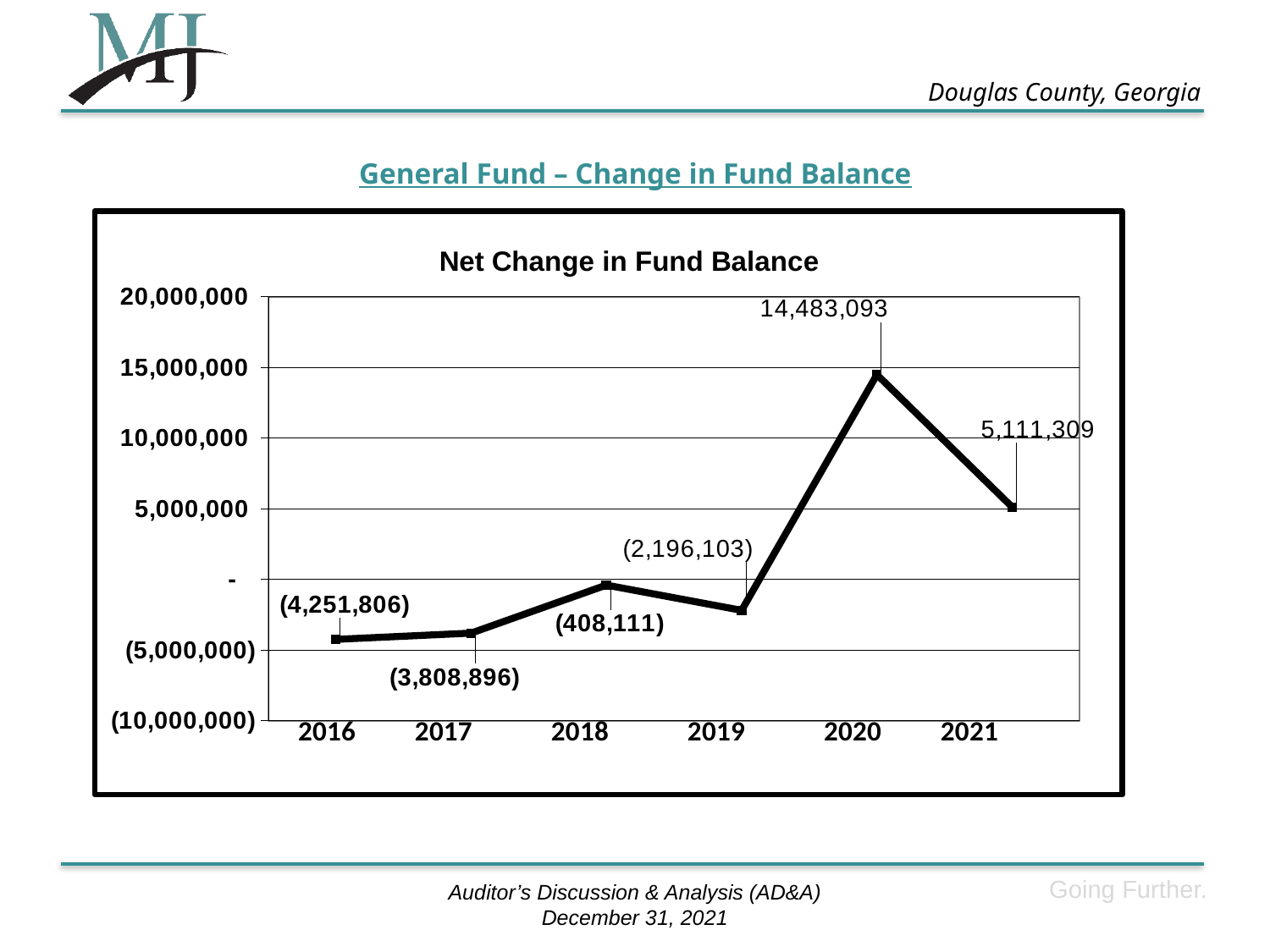
Is the value for 2017 greater or less than 0? less What is the net change in fund balance for 2021? 5,111,309 What is the net change in fund balance for 2018? (408,111) Which year has the lowest net change in fund balance? 2016 Does the net change in fund balance rise or fall from 2019 to 2020? rise Which year has the larger net change in fund balance, 2018 or 2019? 2018 Which year has the highest net change in fund balance? 2020 What is the difference between the net change in fund balance in 2020 and in 2021? 9,371,784 What is the net change in fund balance for 2020? 14,483,093 How many years are plotted on the chart? 6 What is the net change in fund balance for 2016? (4,251,806) What kind of chart is shown on the slide? line chart